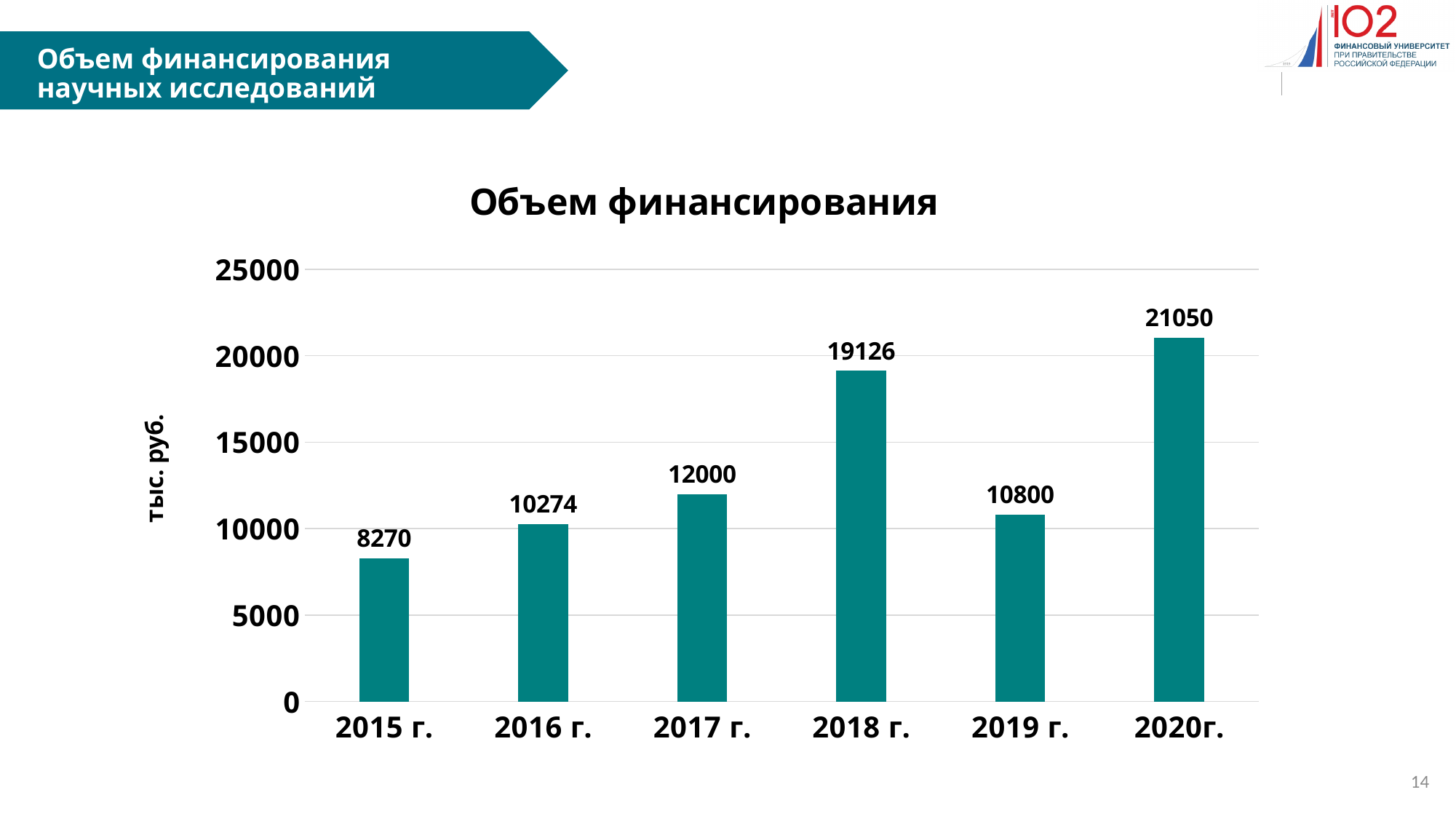
What kind of chart is this? bar chart What is the title of the chart? Объем финансирования What is the difference between the values for 2020г. and 2019 г.? 10250 What is the value for 2019 г.? 10800 Is the value for 2016 г. greater or less than 10000? greater How many years are shown on the x axis? 6 What is the value for 2018 г.? 19126 Which year has the lowest value? 2015 г. Which year has the highest value? 2020г. What is the value for 2015 г.? 8270 What is the difference between the values for 2017 г. and 2016 г.? 1726 Which is larger, the value for 2018 г. or the value for 2017 г.? 2018 г.